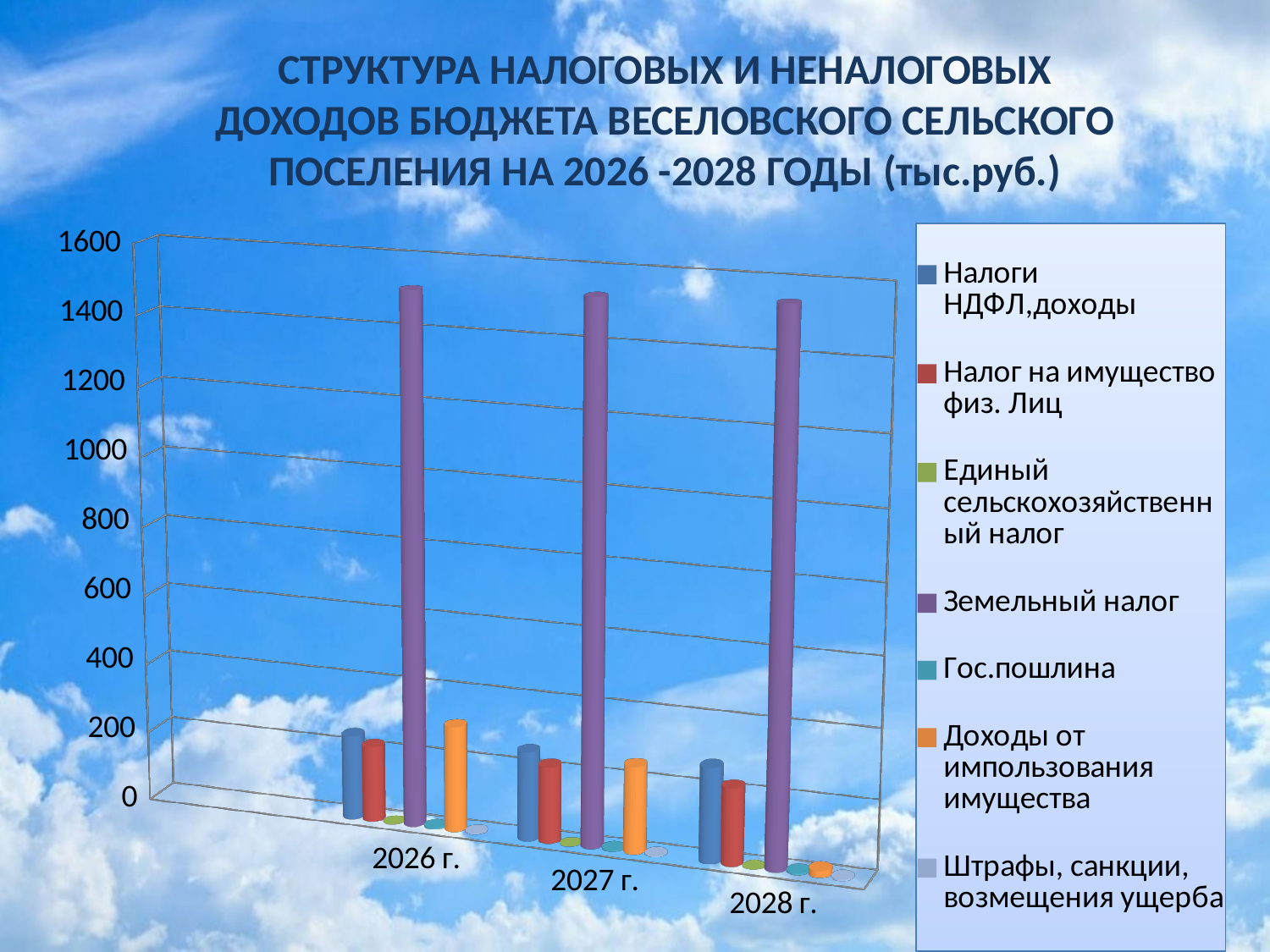
Is the value for Земельный налог in 2026 г. greater or less than 1200? greater Which is larger in 2027 г.: Земельный налог or Налог на имущество физ. Лиц? Земельный налог Which series has the highest value in 2028 г.? Земельный налог How many year categories are shown on the x axis? 3 What kind of chart is shown on the slide? bar chart Is the value for Доходы от импользования имущества in 2028 г. greater or less than 200? less What colour represents Земельный налог in the legend? purple Do the values for Доходы от импользования имущества rise or fall from 2026 г. to 2028 г.? fall Which series has the highest value in 2026 г.? Земельный налог Do the values for Налоги НДФЛ,доходы rise or fall from 2026 г. to 2028 г.? rise Is the value for Налоги НДФЛ,доходы in 2026 г. greater or less than 400? less How many series does the legend list? 7